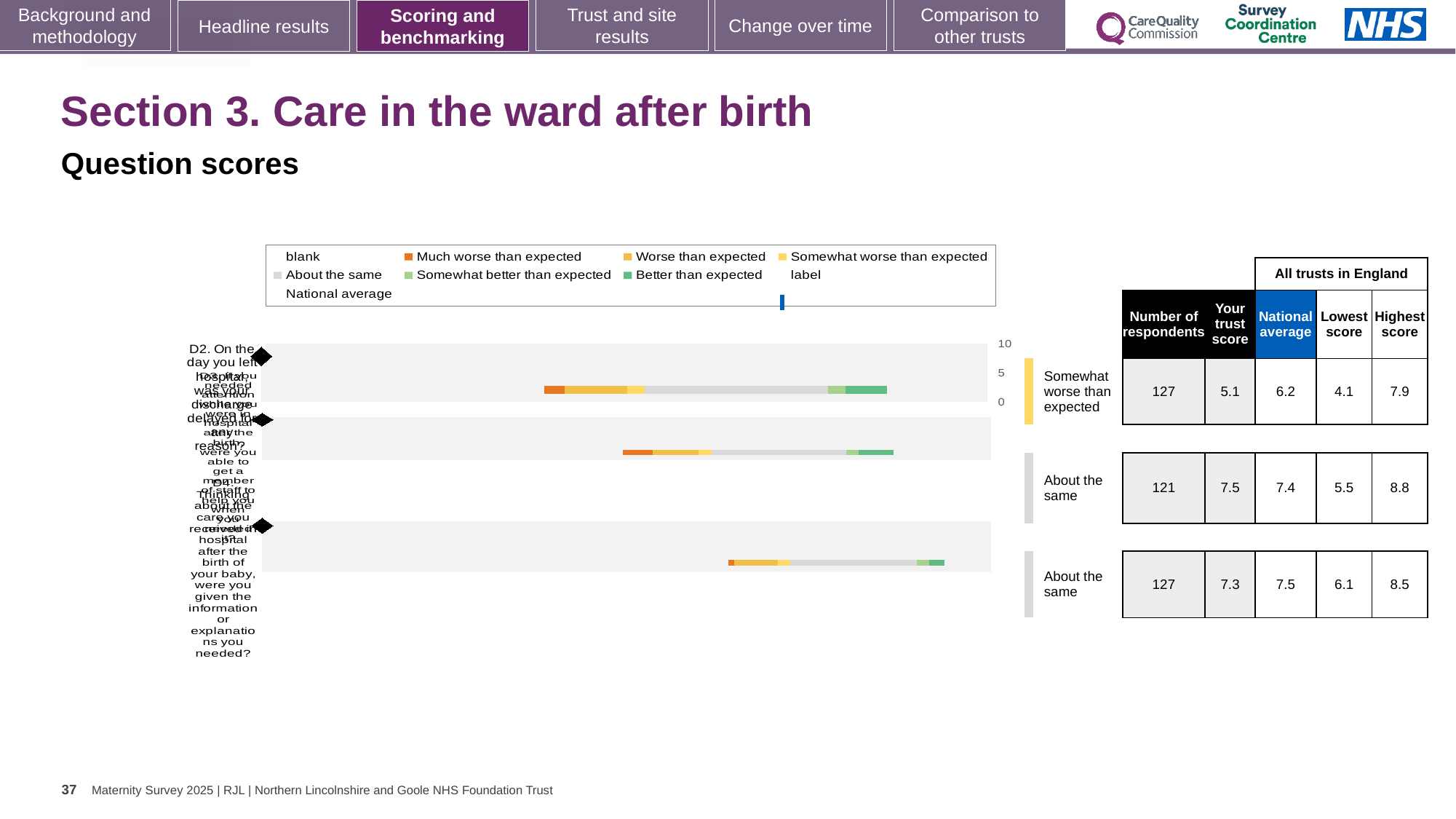
Which legend entry is shown in dark green? Better than expected Which legend entry is shown in orange? Much worse than expected In the table beside the chart, is the 'Your trust score' in the second row larger or smaller than its 'National average'? larger In the table beside the chart, what is the 'Highest score' for the third row? 8.5 What kind of chart is shown on the slide? bar chart In the table beside the chart, which row has the lowest 'Your trust score'? the first row In the table beside the chart, what is the 'National average' for the second row? 7.4 In the table beside the chart, what is the benchmark category shown for the first row? Somewhat worse than expected In the table beside the chart, what is the difference between the 'Highest score' and 'Lowest score' in the first row? 3.8 In the table beside the chart, what is the 'Number of respondents' for the second row? 121 In the table beside the chart, what is the 'Your trust score' for the first row? 5.1 How many horizontal bars (question rows) does the chart contain? 3